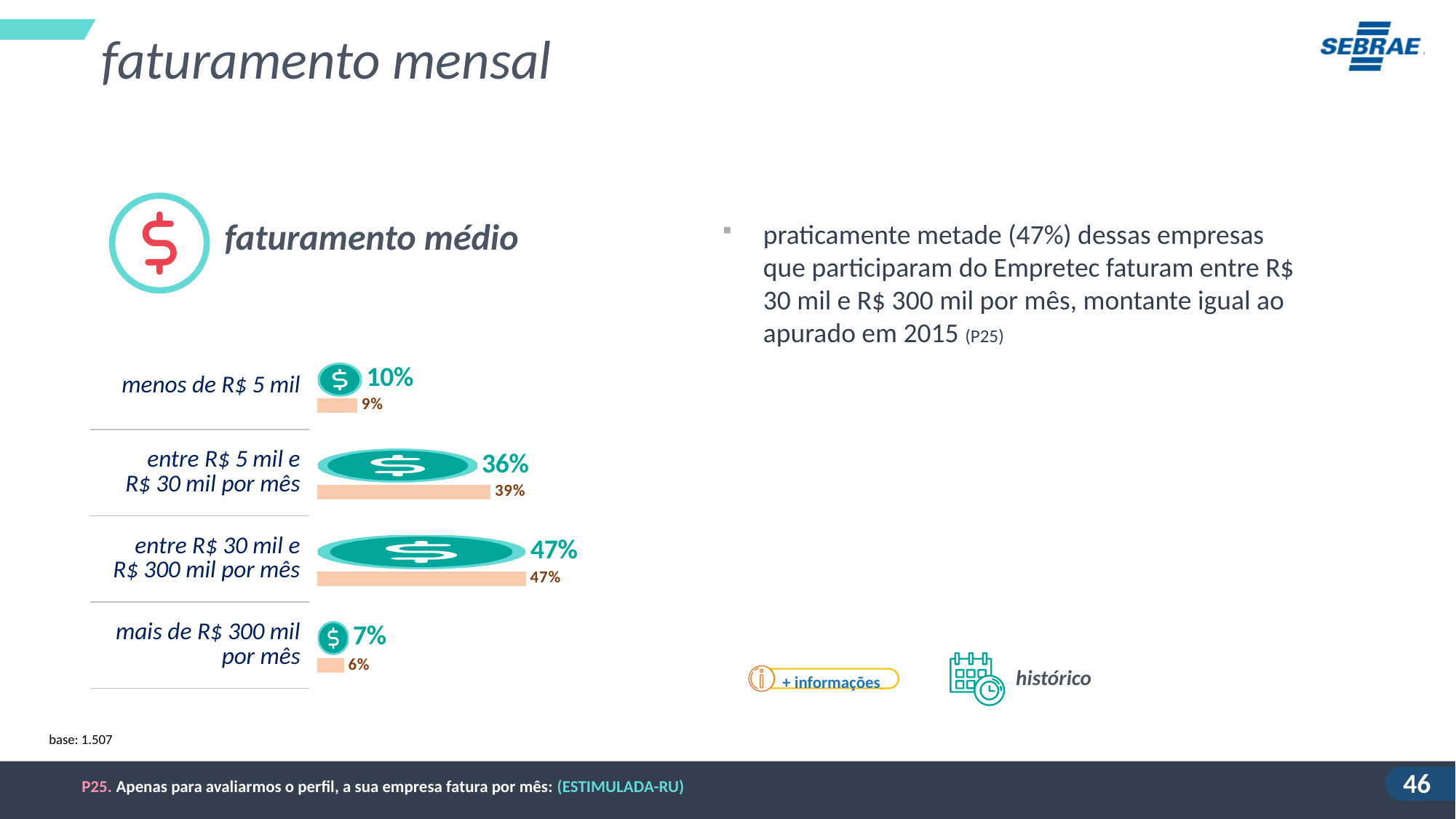
What is the difference between the teal and peach values for 'entre R$ 5 mil e R$ 30 mil por mês'? 3 percentage points What is the base (sample size) shown for the chart? 1.507 Which category has the highest teal (dollar-icon) value? entre R$ 30 mil e R$ 300 mil por mês How many revenue categories are shown in the chart? 4 What kind of chart is shown on the slide? bar chart What is the peach bar value for 'entre R$ 5 mil e R$ 30 mil por mês'? 39% For 'menos de R$ 5 mil', which is larger: the teal value or the peach value? the teal value (10%) What is the peach bar value for 'mais de R$ 300 mil por mês'? 6% What is the teal (dollar-icon) value for 'entre R$ 30 mil e R$ 300 mil por mês'? 47% Which category has the lowest peach bar value? mais de R$ 300 mil por mês How many series (bar colours) are shown for each category? 2 What is the teal (dollar-icon) value for 'menos de R$ 5 mil'? 10%